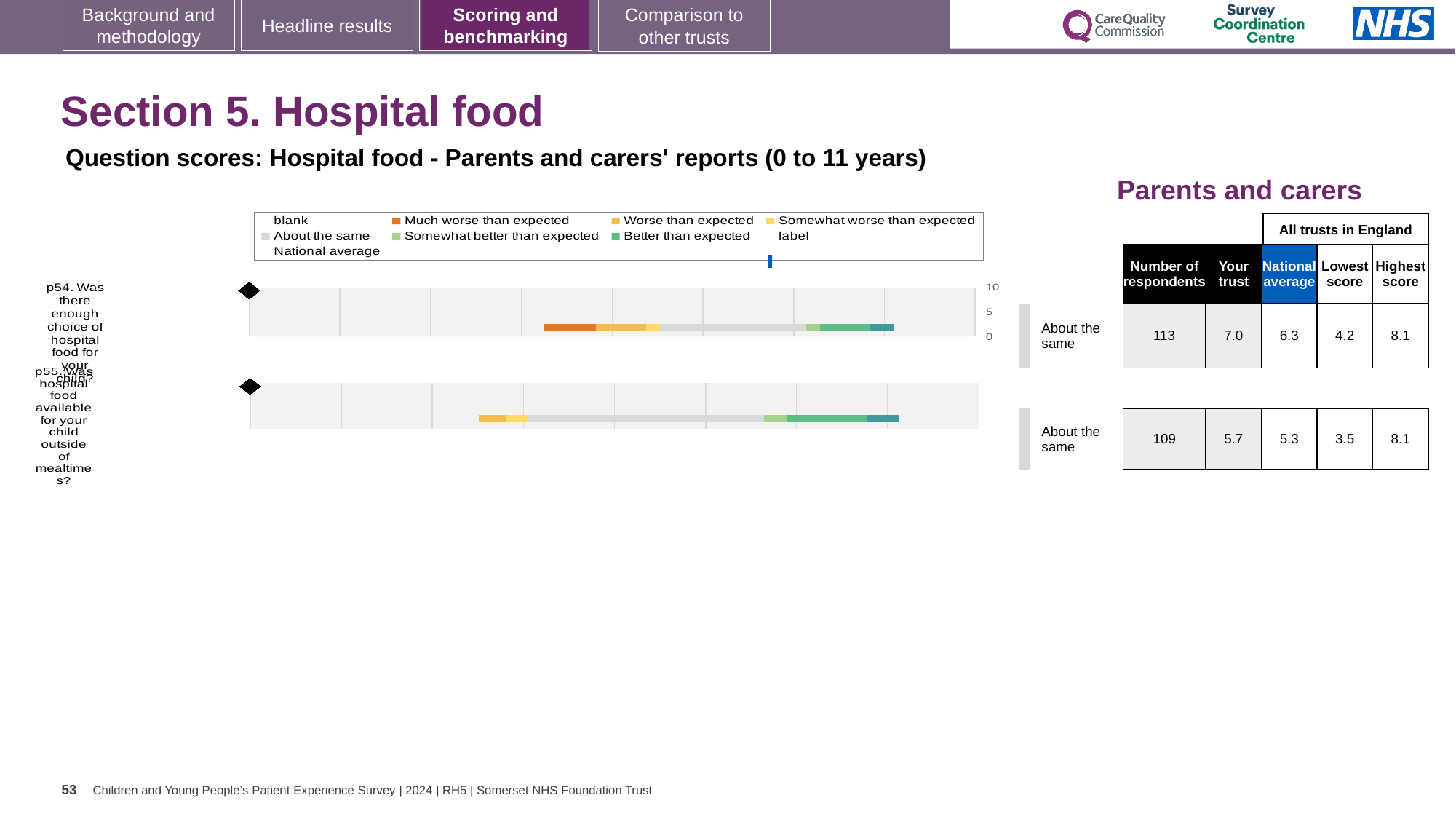
What is the lowest score across all trusts in England for p55? 3.5 What benchmark category is given for p55 next to the chart? About the same How many questions (categories) are plotted in the chart? 2 What is the difference between the 'Your trust' score and the national average for p54? 0.7 According to the table beside the chart, what is the 'Your trust' score for p54 (enough choice of hospital food)? 7.0 How many respondents answered p54? 113 What colour does the legend use for 'Much worse than expected'? orange How many entries does the chart legend list? 9 According to the table beside the chart, what is the 'Your trust' score for p55 (hospital food available outside of mealtimes)? 5.7 What is the national average score for p54 shown in the table? 6.3 Which question has the higher 'Your trust' score, p54 or p55? p54 What kind of chart is shown on the slide? bar chart